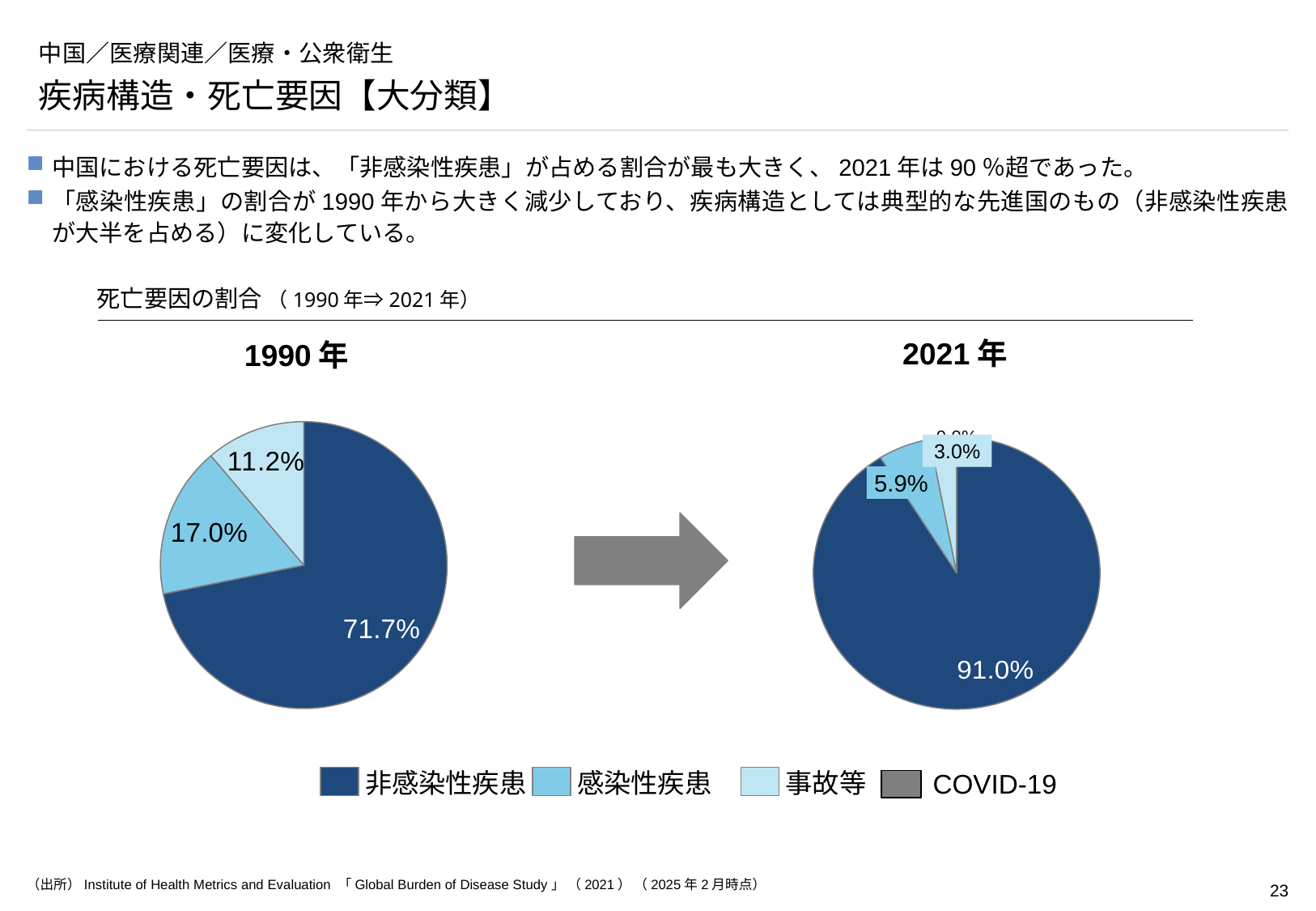
In the 2021年 pie chart, what share is shown for 事故等? 3.0% In the 1990年 pie chart, which category has the largest share? 非感染性疾患 What type of chart is used to show 死亡要因の割合 for 1990年 and 2021年? Pie chart Is the share of 感染性疾患 larger in the 1990年 chart or the 2021年 chart? 1990年 How many categories does the legend list for the pie charts? 4 By how many percentage points did the share of 非感染性疾患 increase from the 1990年 chart to the 2021年 chart? 19.3 percentage points What is the difference between the 感染性疾患 share in the 1990年 chart and in the 2021年 chart? 11.1 percentage points In the 2021年 pie chart, what share is shown for 非感染性疾患? 91.0% In the 1990年 pie chart, what share is shown for 感染性疾患? 17.0% In the 1990年 pie chart, what share is shown for 非感染性疾患? 71.7% Which legend category is shown in gray? COVID-19 In the 1990年 pie chart, which labelled category has the smallest share? 事故等